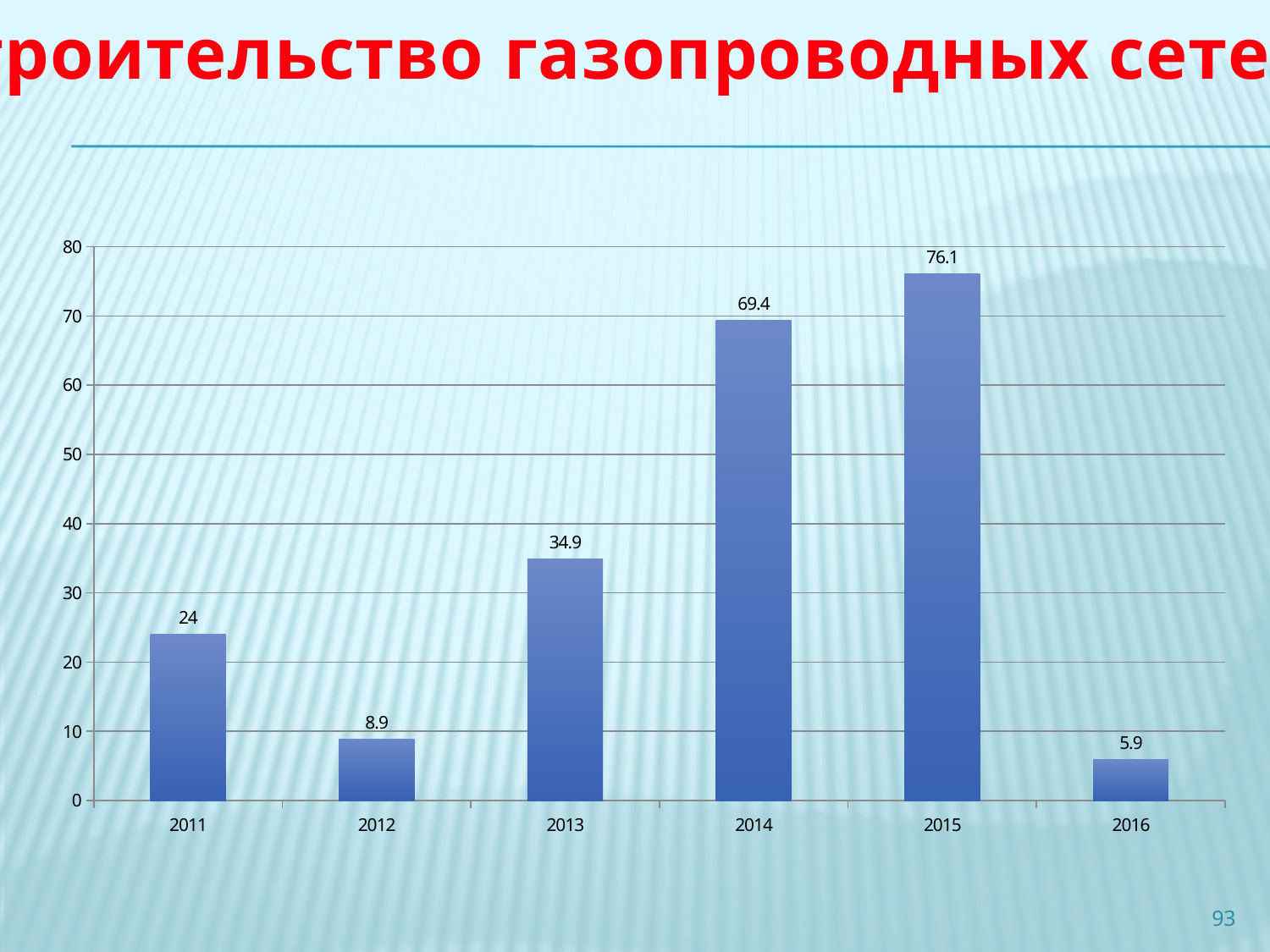
Which is larger, the value for 2011 or the value for 2012? 2011 What is the difference between the values for 2013 and 2012? 26 Do the values rise or fall from 2015 to 2016? fall What is the value for 2016? 5.9 Is the value for 2013 greater or less than 30? greater Which year has the highest value? 2015 How many years are shown on the x axis? 6 What is the value for 2011? 24 What is the value for 2014? 69.4 What is the difference between the values for 2015 and 2014? 6.7 Which year has the lowest value? 2016 What kind of chart is shown on the slide? bar chart